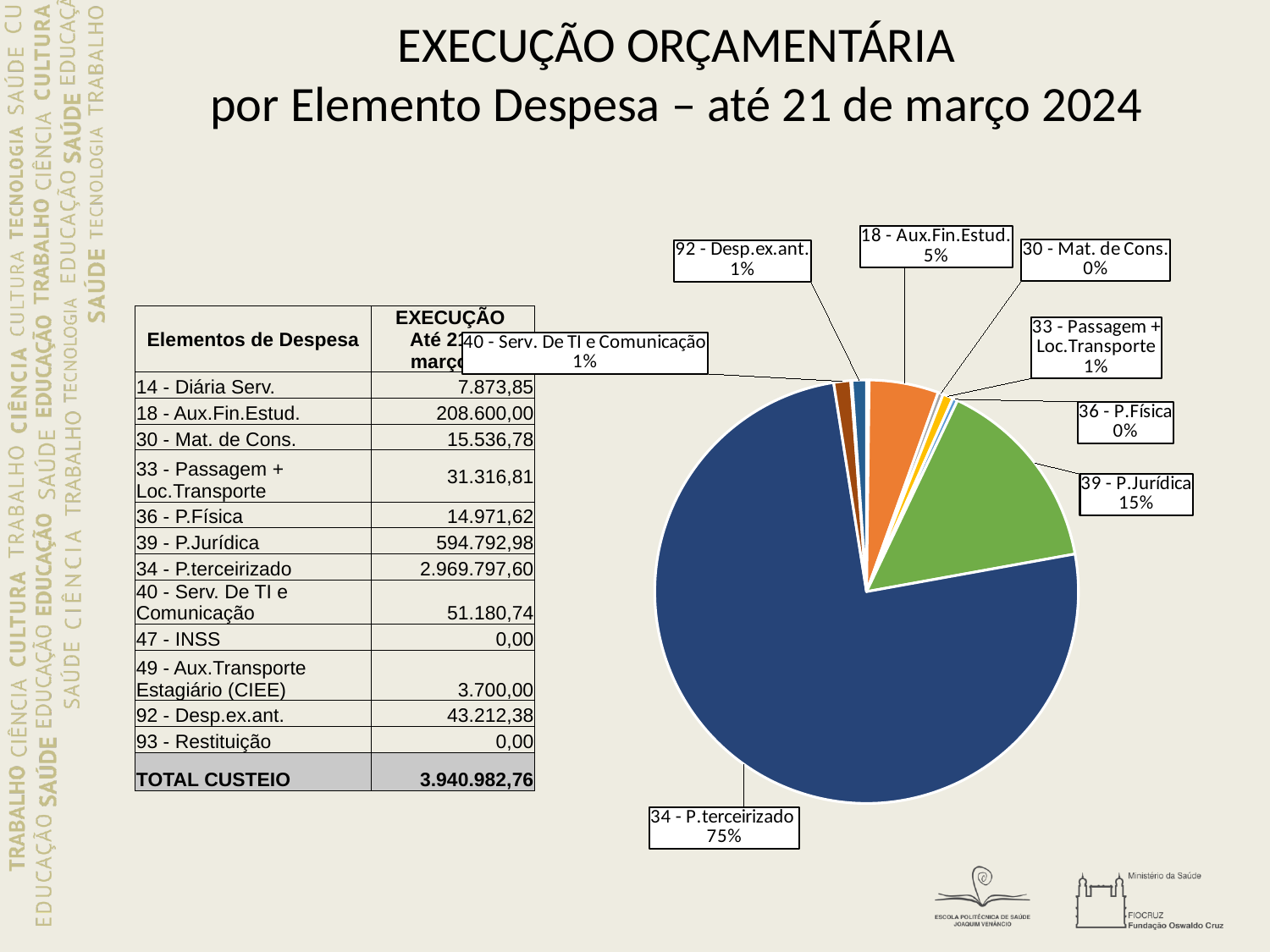
What percentage is shown for 36 - P.Física in the pie chart? 0% What is the difference in percentage points between the 34 - P.terceirizado slice and the 39 - P.Jurídica slice? 60 percentage points What percentage is shown for 18 - Aux.Fin.Estud. in the pie chart? 5% Which category has the largest slice of the pie chart? 34 - P.terceirizado Which slice is larger in the pie chart: 39 - P.Jurídica or 18 - Aux.Fin.Estud.? 39 - P.Jurídica What percentage is shown for 30 - Mat. de Cons. in the pie chart? 0% What percentage is shown for 33 - Passagem + Loc.Transporte in the pie chart? 1% What percentage is shown for 92 - Desp.ex.ant. in the pie chart? 1% What share of the pie does 39 - P.Jurídica represent? 15% What is the title of the slide containing the pie chart? EXECUÇÃO ORÇAMENTÁRIA por Elemento Despesa – até 21 de março 2024 What share of the pie does 34 - P.terceirizado represent? 75% What kind of chart is shown on the slide? pie chart